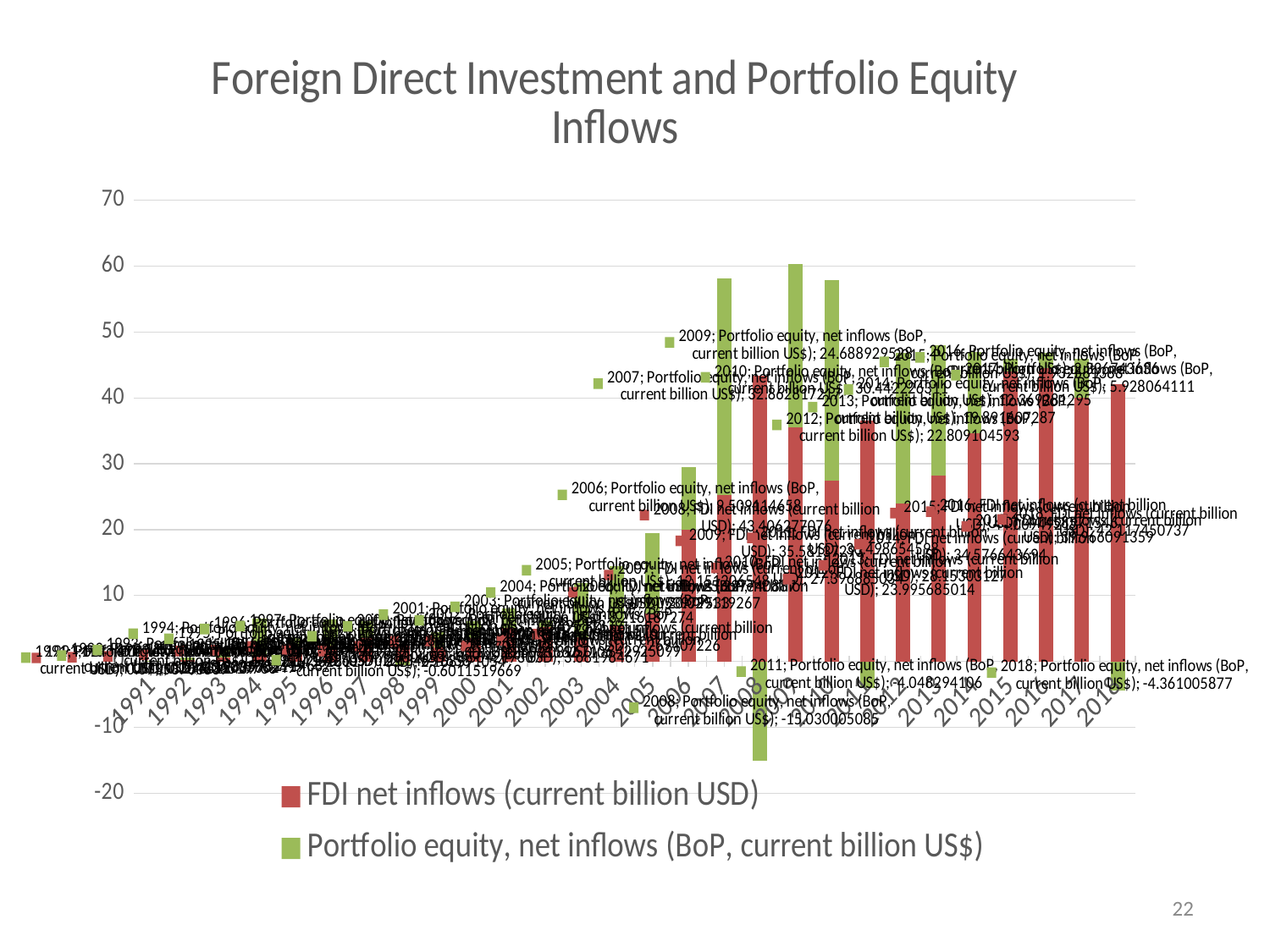
Which is larger, Portfolio equity, net inflows in 2009 or in 2012? 2009 What are the two series named in the legend? FDI net inflows (current billion USD); Portfolio equity, net inflows (BoP, current billion US$) Do FDI net inflows generally rise or fall from 1991 to 2018? rise What is the title of the chart? Foreign Direct Investment and Portfolio Equity Inflows What kind of chart is shown on the slide? bar chart What is the value of Portfolio equity, net inflows for 2008? -15.030005085 Is the Portfolio equity, net inflows value for 2008 greater or less than 0? less Which year has the lowest Portfolio equity, net inflows value? 2008 What is the value of Portfolio equity, net inflows for 2018? -4.361005877 How many years are shown on the x axis? 28 How many series does the legend list? 2 What is the value of Portfolio equity, net inflows for 2011? -4.048294106